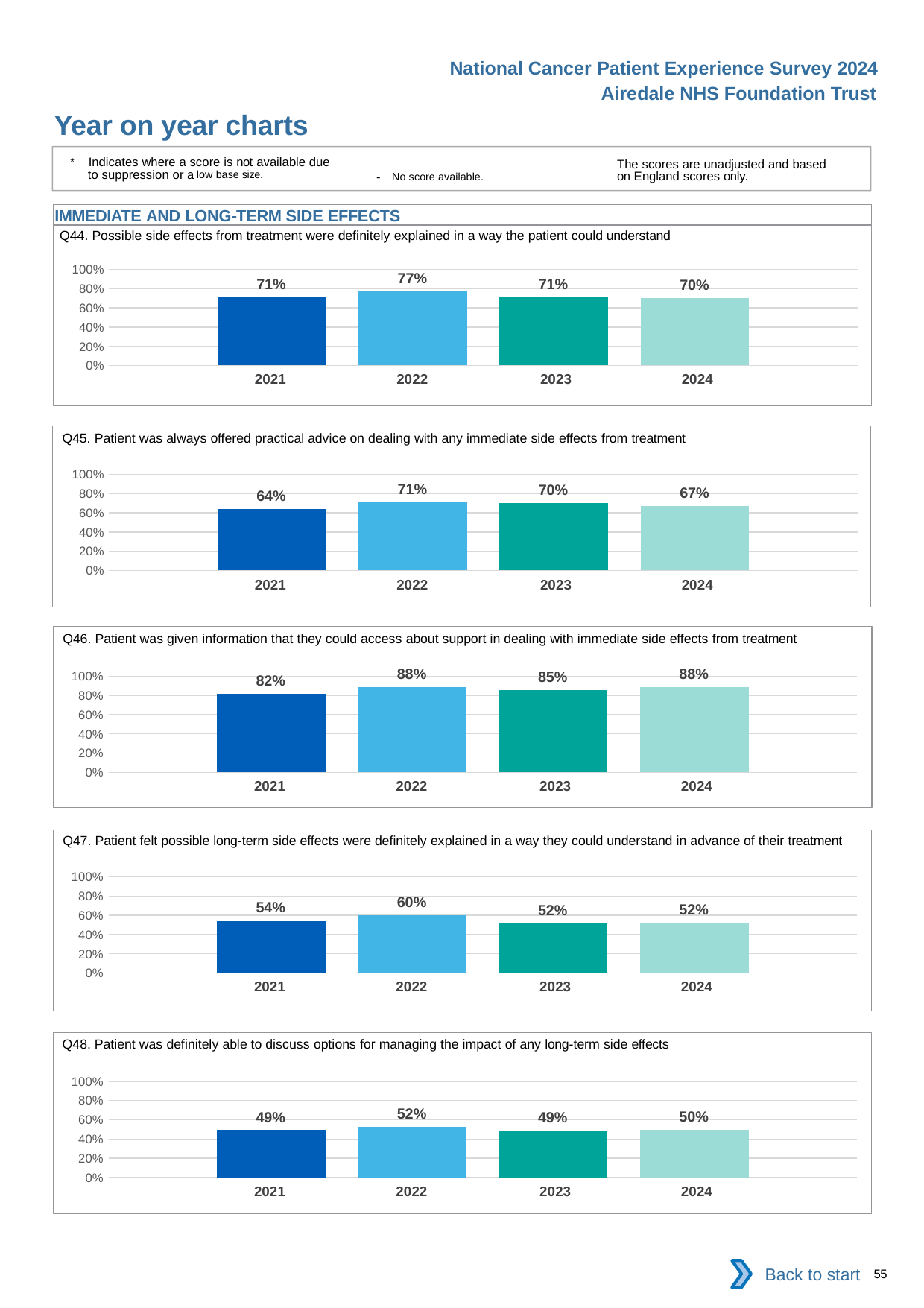
In the Q45 chart, is the value for 2022 larger than the value for 2024? Yes In the Q44 chart, what is the difference between the 2022 and 2024 values? 7% What is the section heading above the Q44 chart? IMMEDIATE AND LONG-TERM SIDE EFFECTS What kind of chart is the Q46 chart? Bar chart In the Q47 chart, which year has the highest value? 2022 In the Q47 chart, is the value for 2021 greater or less than 60%? less In the Q48 chart, what is the value for 2024? 50% In the Q48 chart, what is the value for 2021? 49% In the Q45 chart, which year has the lowest value? 2021 In the Q46 chart, what is the difference between the 2022 and 2021 values? 6% How many years are shown in the Q44 chart? 4 In the Q44 chart, what is the value for 2022? 77%